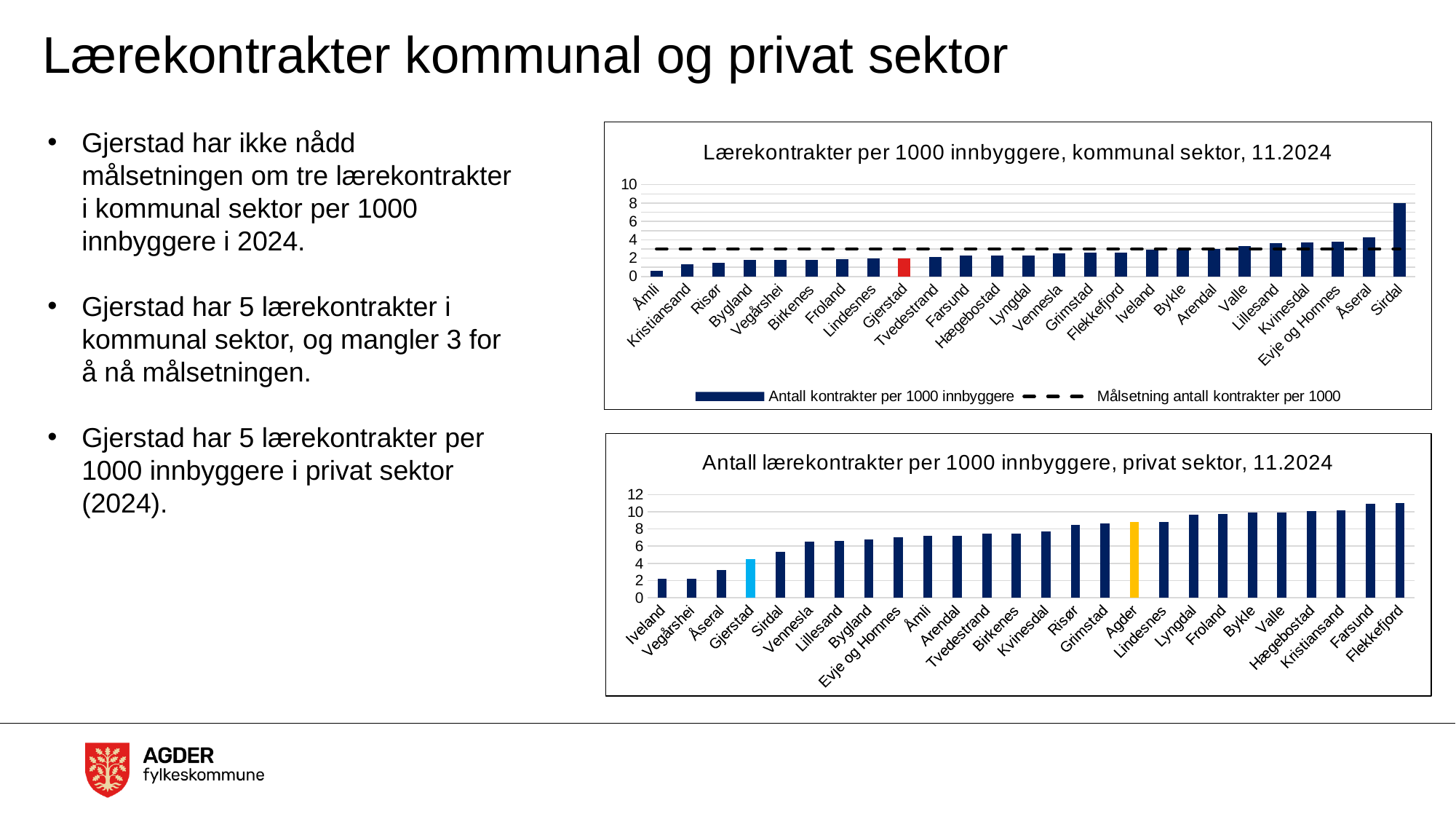
In the bottom chart (privat sektor), is the value for Iveland greater or less than 4? less In the top chart (kommunal sektor), how many municipalities are shown on the x axis? 25 In the top chart (kommunal sektor), which municipality has the highest number of lærekontrakter per 1000 innbyggere? Sirdal What kind of chart is the bottom chart (privat sektor)? bar chart In the bottom chart (privat sektor), which is larger, the value for Flekkefjord or the value for Iveland? Flekkefjord In the top chart (kommunal sektor), which municipality's bar is coloured red? Gjerstad In the top chart (kommunal sektor), how many series does the legend list? 2 In the bottom chart (privat sektor), do the values rise or fall from left to right along the x axis? rise In the bottom chart (privat sektor), is the value for Flekkefjord greater or less than 10? greater In the top chart (kommunal sektor), is the value for Gjerstad greater or less than 3? less In the top chart (kommunal sektor), which municipality has the lowest number of lærekontrakter per 1000 innbyggere? Åmli